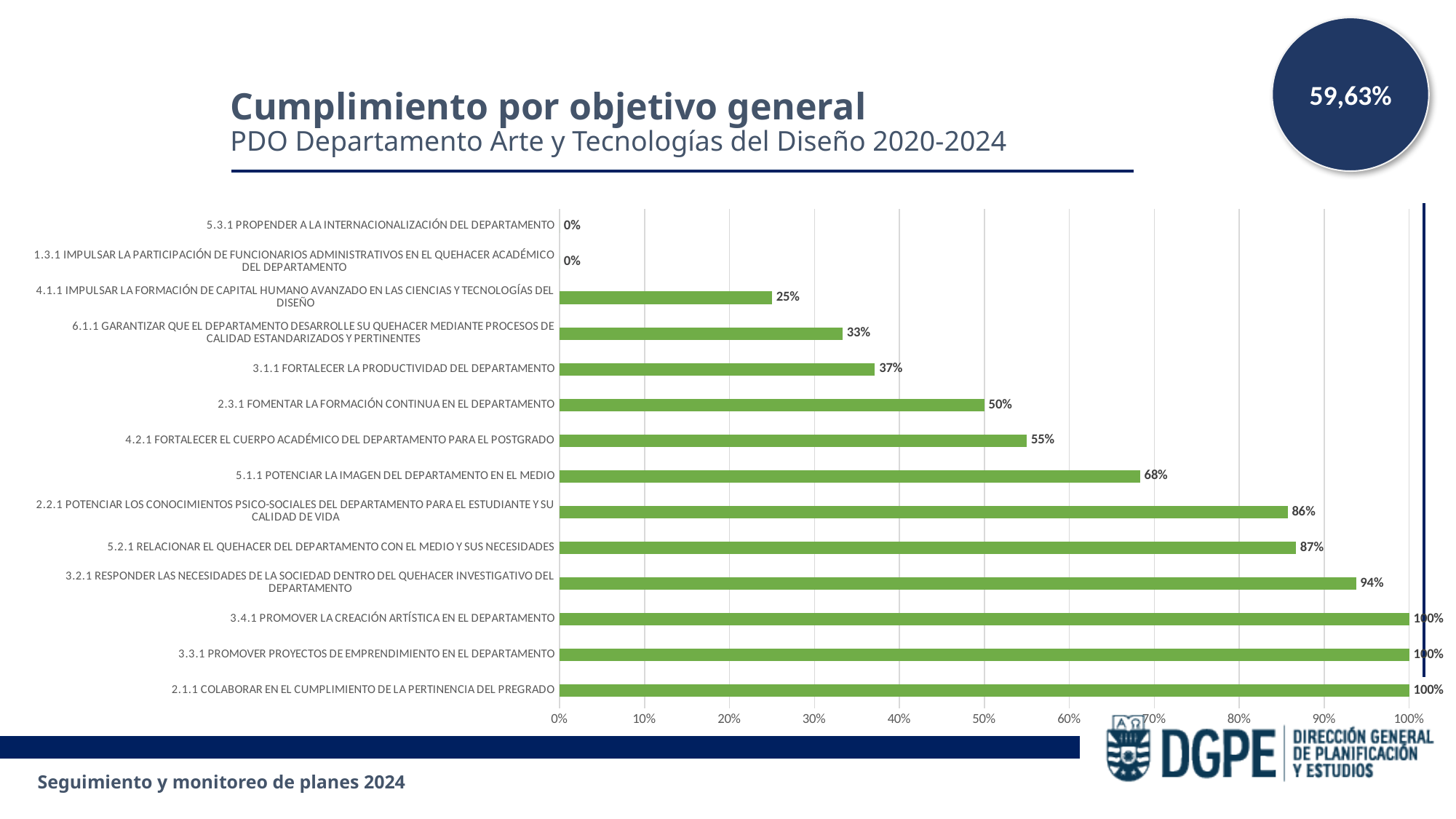
What is the difference between the values for 5.2.1 RELACIONAR EL QUEHACER DEL DEPARTAMENTO CON EL MEDIO Y SUS NECESIDADES and 4.2.1 FORTALECER EL CUERPO ACADÉMICO DEL DEPARTAMENTO PARA EL POSTGRADO? 32% What is the value for 4.1.1 IMPULSAR LA FORMACIÓN DE CAPITAL HUMANO AVANZADO EN LAS CIENCIAS Y TECNOLOGÍAS DEL DISEÑO? 25% What is the value for 2.3.1 FOMENTAR LA FORMACIÓN CONTINUA EN EL DEPARTAMENTO? 50% How many categories have a value of 100%? 3 What is the value for 3.2.1 RESPONDER LAS NECESIDADES DE LA SOCIEDAD DENTRO DEL QUEHACER INVESTIGATIVO DEL DEPARTAMENTO? 94% What kind of chart is shown on the slide? Bar chart How many categories have a value of 0%? 2 Which has a larger value: 6.1.1 GARANTIZAR QUE EL DEPARTAMENTO DESARROLLE SU QUEHACER MEDIANTE PROCESOS DE CALIDAD ESTANDARIZADOS Y PERTINENTES or 2.2.1 POTENCIAR LOS CONOCIMIENTOS PSICO-SOCIALES DEL DEPARTAMENTO PARA EL ESTUDIANTE Y SU CALIDAD DE VIDA? 2.2.1 POTENCIAR LOS CONOCIMIENTOS PSICO-SOCIALES DEL DEPARTAMENTO PARA EL ESTUDIANTE Y SU CALIDAD DE VIDA What is the title of the chart on the slide? Cumplimiento por objetivo general How many categories are shown in the chart? 14 What is the value for 3.1.1 FORTALECER LA PRODUCTIVIDAD DEL DEPARTAMENTO? 37% What is the value for 5.1.1 POTENCIAR LA IMAGEN DEL DEPARTAMENTO EN EL MEDIO? 68%